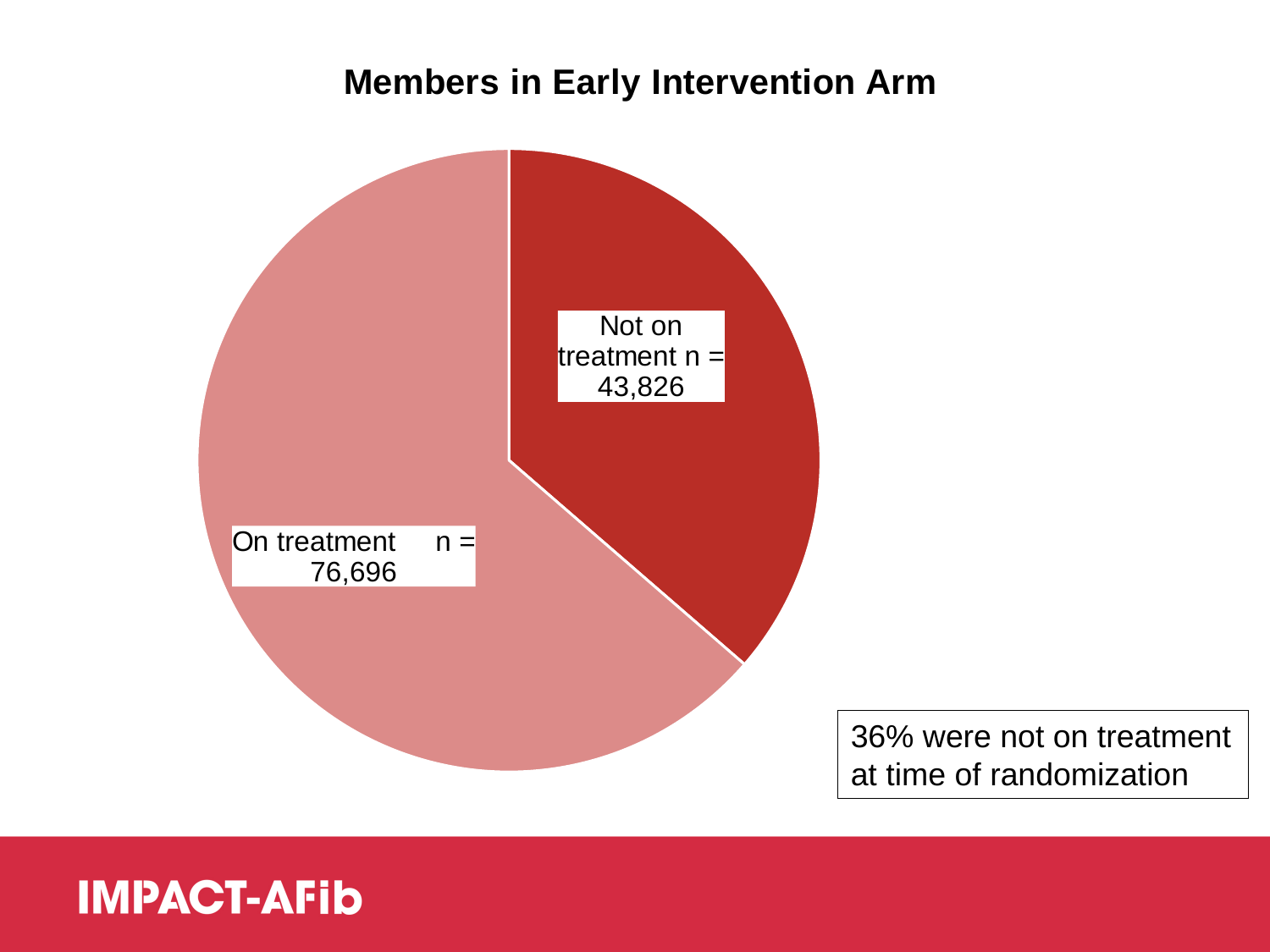
Which slice is the smallest in the pie chart? Not on treatment What is the value (n) for the 'Not on treatment' slice? 43,826 What is the title of the chart? Members in Early Intervention Arm What is the total number of members represented in the pie chart? 120,522 What kind of chart is shown on the slide? Pie chart Which slice is shown in the darker red colour? Not on treatment Which slice is the largest in the pie chart? On treatment Which is larger, the number on treatment or the number not on treatment? On treatment What is the difference between the number on treatment and the number not on treatment? 32,870 What is the value (n) for the 'On treatment' slice? 76,696 What share of members were not on treatment at time of randomization, according to the slide? 36% How many slices does the pie chart have? 2